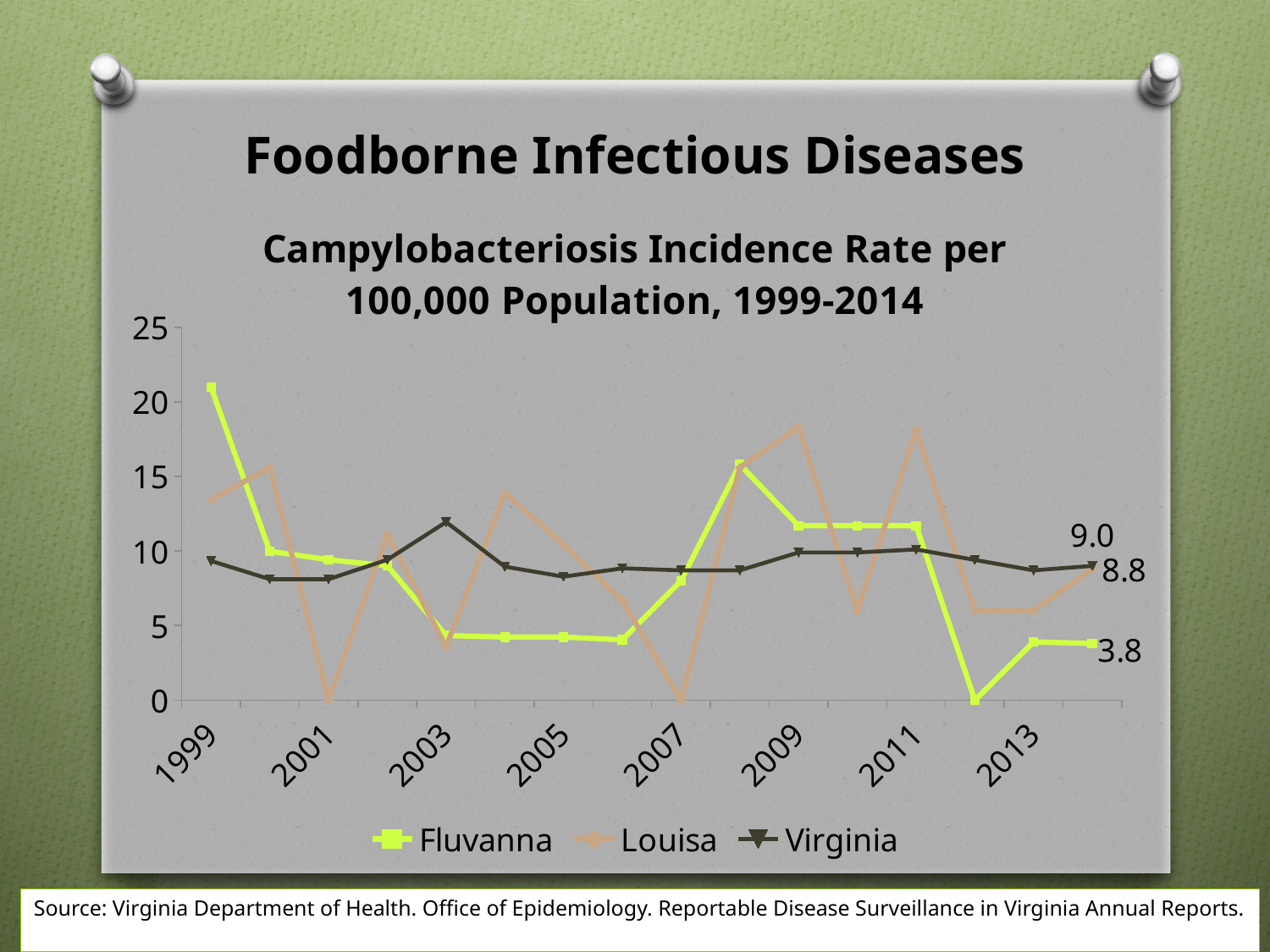
How many series does the legend list? 3 Is the Louisa incidence rate in 2009 greater or less than 15? greater Is the Fluvanna incidence rate in 1999 greater or less than 20? greater In which year is the Virginia incidence rate highest? 2003 How many years are plotted on the x axis of the chart? 16 In 2014, which series has the higher incidence rate, Fluvanna or Virginia? Virginia What kind of chart is shown on the slide? line chart What is the Campylobacteriosis incidence rate for Fluvanna in 2014? 3.8 In which year is the Fluvanna incidence rate highest? 1999 In which year is the Fluvanna incidence rate lowest? 2012 In 1999, which series has the higher incidence rate, Fluvanna or Louisa? Fluvanna Is the Fluvanna incidence rate in 2005 greater or less than 5? less